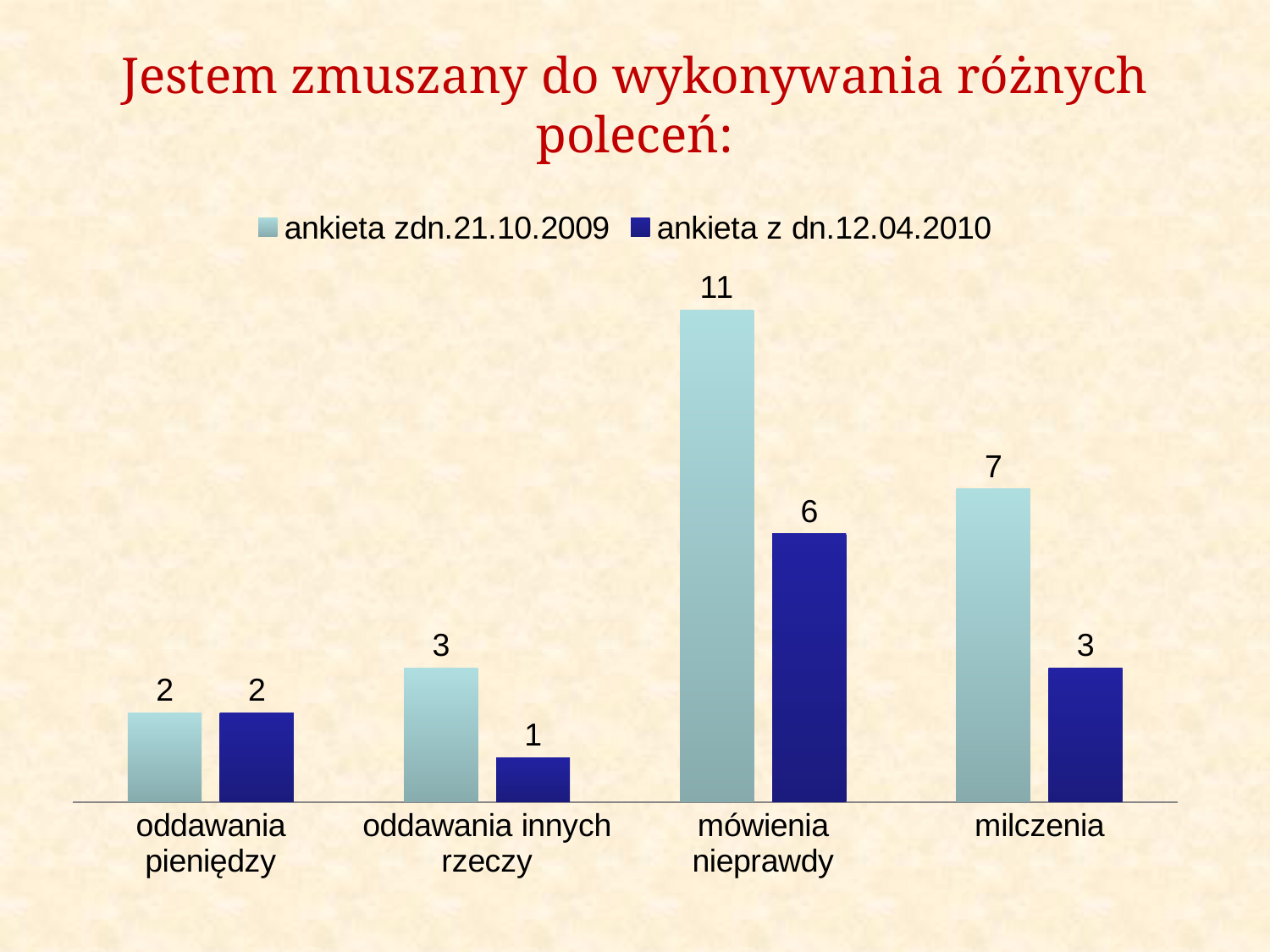
What is the value for "mówienia nieprawdy" in the "ankieta zdn.21.10.2009" series? 11 What is the difference between the two series for "mówienia nieprawdy"? 5 What kind of chart is shown on the slide? bar chart Which category has the lowest value in the "ankieta z dn.12.04.2010" series? oddawania innych rzeczy What is the value for "milczenia" in the "ankieta z dn.12.04.2010" series? 3 Which category has the highest value in the "ankieta zdn.21.10.2009" series? mówienia nieprawdy What is the value for "oddawania innych rzeczy" in the "ankieta z dn.12.04.2010" series? 1 How many series does the legend list? 2 What is the title of the slide? Jestem zmuszany do wykonywania różnych poleceń: What is the difference between the two series for "milczenia"? 4 How many categories are shown on the x axis? 4 Which is larger for "oddawania innych rzeczy": the "ankieta zdn.21.10.2009" value or the "ankieta z dn.12.04.2010" value? ankieta zdn.21.10.2009